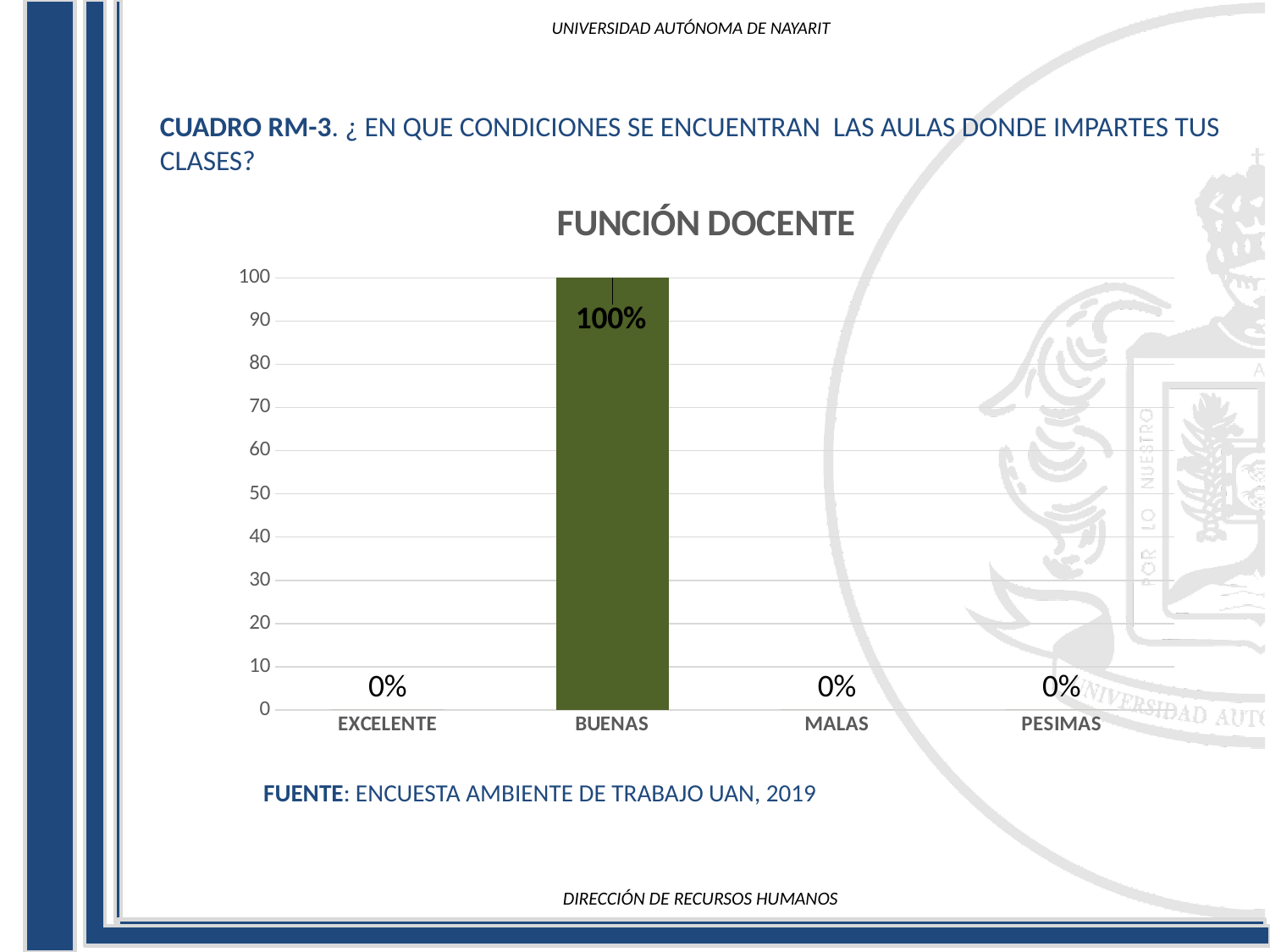
What is the maximum value shown on the y axis? 100 What is the value for BUENAS? 100% How many categories are shown on the x axis? 4 What is the value for EXCELENTE? 0% Which is larger, the value for BUENAS or the value for EXCELENTE? BUENAS What kind of chart is shown on the slide? bar chart What is the title of the chart? FUNCIÓN DOCENTE What is the value for MALAS? 0% Is the value for BUENAS greater or less than 50? greater What is the difference between the values for BUENAS and MALAS? 100% Which category has the highest value? BUENAS What is the value for PESIMAS? 0%